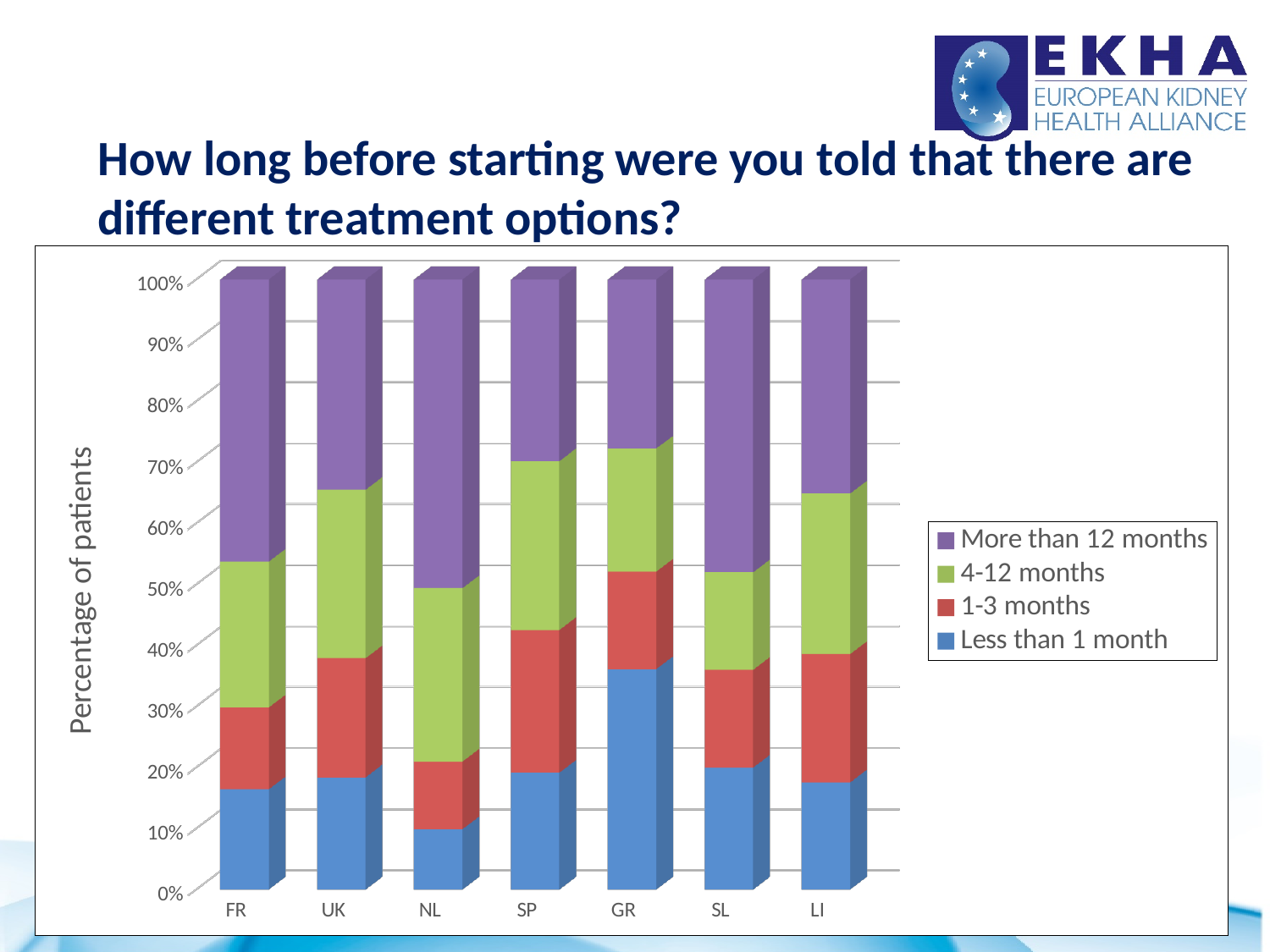
What is the title of the vertical axis of the chart? Percentage of patients Which country has the lowest share of patients told less than 1 month before starting? NL Is the 'Less than 1 month' value for NL greater or less than 20%? less Is the 'Less than 1 month' value for FR greater or less than 20%? less Which country has the highest share of patients told less than 1 month before starting? GR How many countries are shown on the x axis of the chart? 7 Which has a larger 'Less than 1 month' share, UK or NL? UK What kind of chart is shown on the slide? Stacked bar chart How many series does the chart's legend list? 4 Is the 'Less than 1 month' value for GR greater or less than 30%? greater Which has a larger 'Less than 1 month' share, GR or FR? GR Which legend entry is shown in purple? More than 12 months